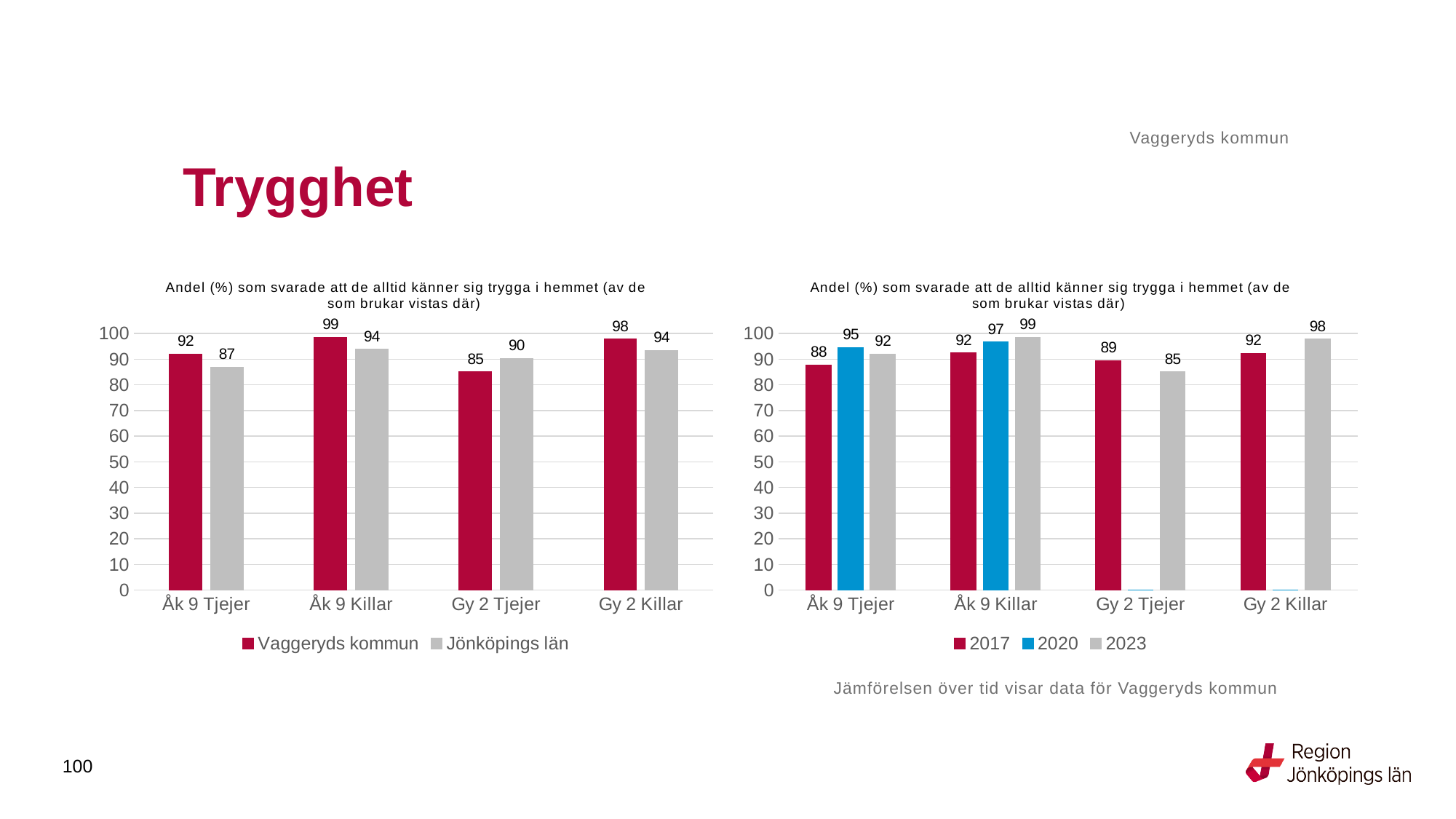
In the right chart, what is the value for 2023 for Gy 2 Tjejer? 85 In the left chart, what is the difference between Vaggeryds kommun and Jönköpings län for Gy 2 Killar? 4 In the right chart, which category has the lowest value for 2017? Åk 9 Tjejer How many series does the legend of the right chart list? 3 In the right chart, what is the difference between the 2023 and 2017 values for Gy 2 Killar? 6 What kind of chart is the left chart? Bar chart In the left chart, for Gy 2 Tjejer, which is larger: Vaggeryds kommun or Jönköpings län? Jönköpings län In the left chart, what is the value for Vaggeryds kommun for Åk 9 Tjejer? 92 In the left chart, what is the value for Jönköpings län for Gy 2 Tjejer? 90 In the left chart, which category has the highest value for Vaggeryds kommun? Åk 9 Killar In the left chart, which category has the lowest value for Jönköpings län? Åk 9 Tjejer In the right chart, what is the value for 2020 for Åk 9 Killar? 97